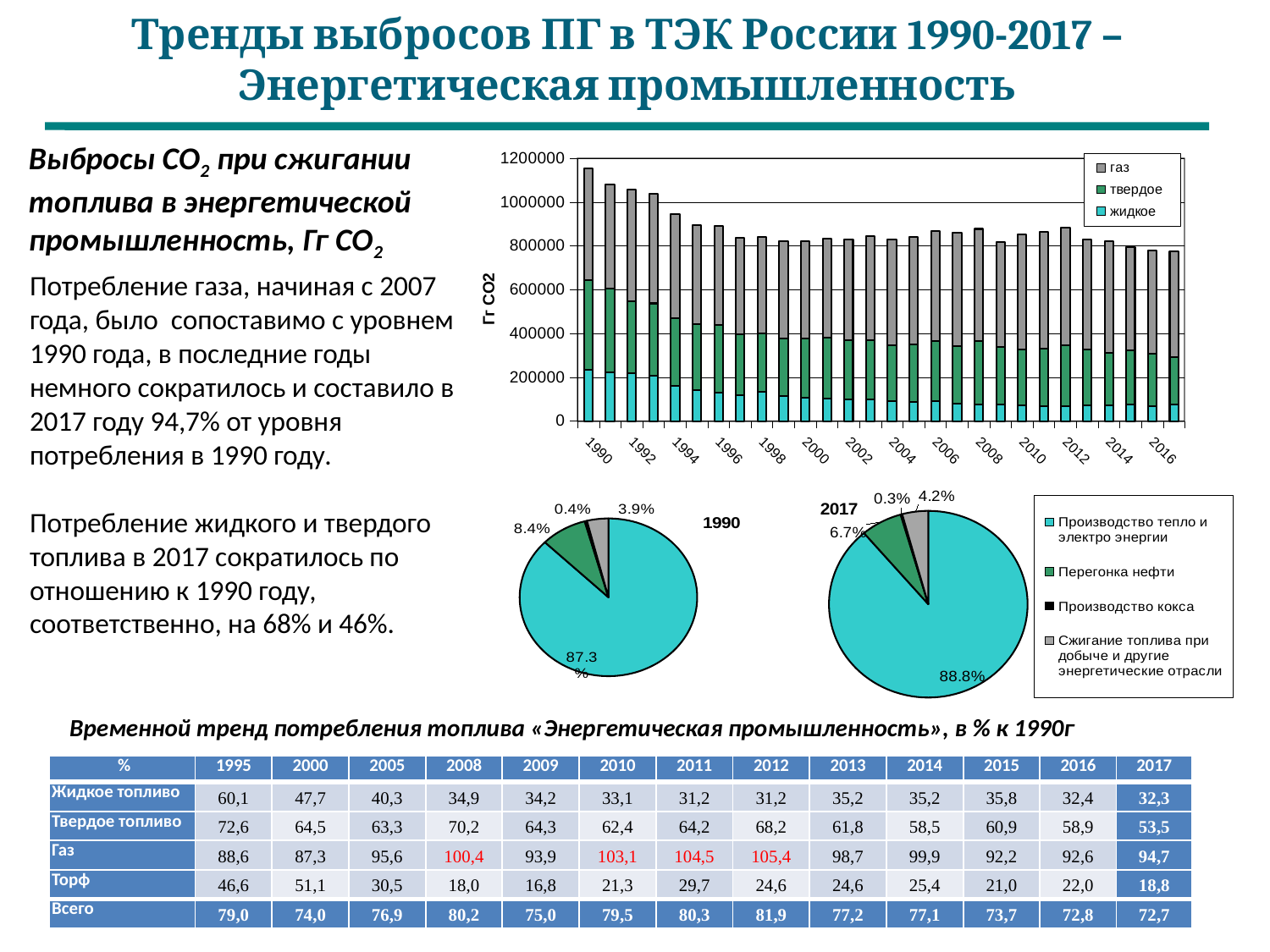
In the 1990 pie chart, which category has the smallest share? Производство кокса In the top-right bar chart, is the total value for 2016 greater or less than 800000? less What kind of chart is the large chart at the top right of the slide? bar chart In the top-right bar chart, which year has the highest total bar? 1990 In the top-right bar chart, is the total value for 1990 greater or less than 1000000? greater What is the difference between the share of Производство тепло и электро энергии in the 2017 pie chart and in the 1990 pie chart? 1.5% What is the label on the vertical axis of the top-right bar chart? Гг CO2 In the top-right bar chart, do the total values generally rise or fall from 1990 to 2017? fall Which is larger: the share of Перегонка нефти in the 1990 pie chart or in the 2017 pie chart? 1990 In the 1990 pie chart, what share does Перегонка нефти have? 8.4% In the 2017 pie chart, what share does Производство тепло и электро энергии have? 88.8% How many series does the legend of the top-right bar chart list? 3